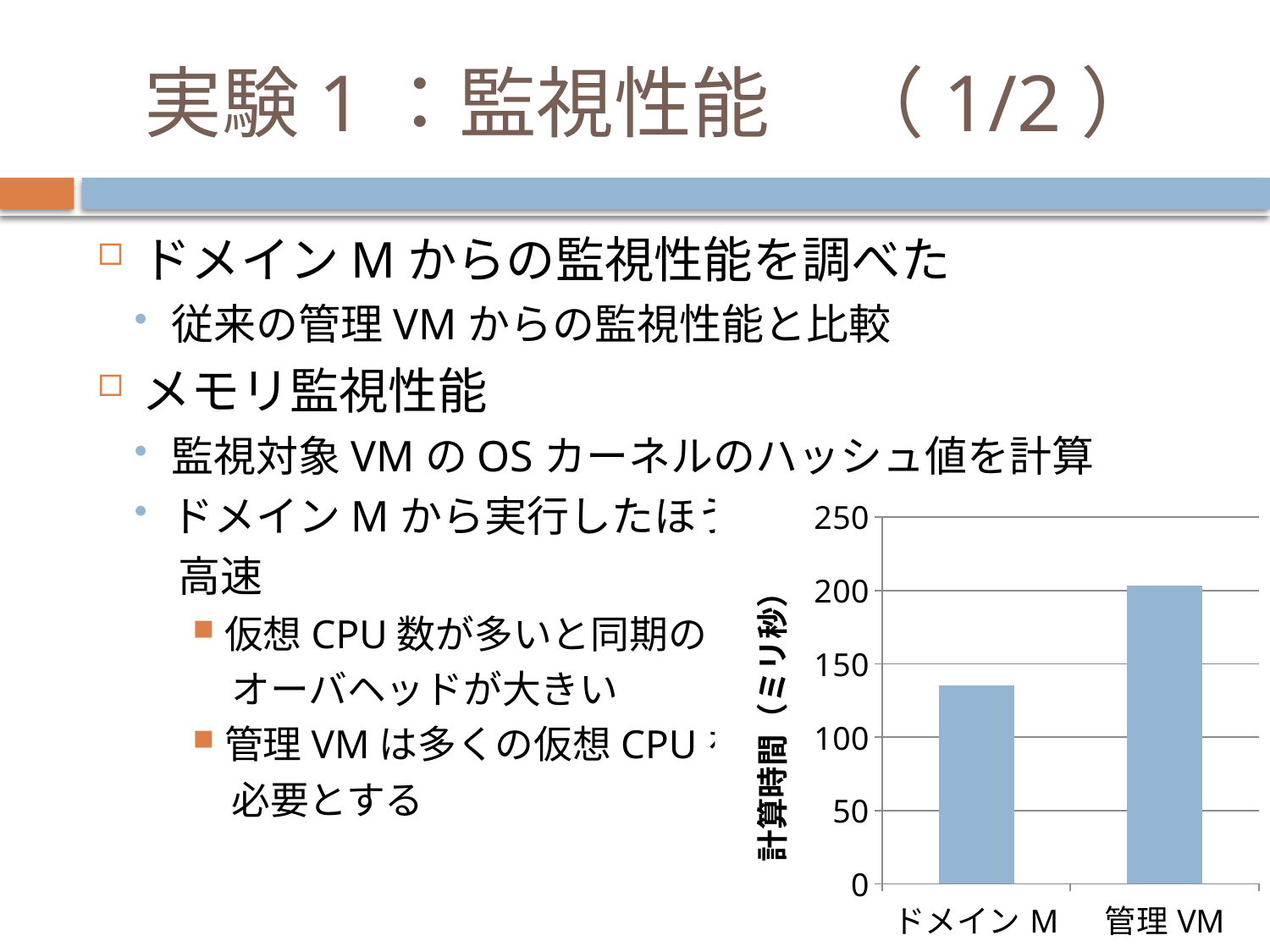
What is the label of the vertical axis of the chart? 計算時間（ミリ秒） Is the value for ドメイン M greater or less than 150? less Which has a larger 計算時間, ドメイン M or 管理 VM? 管理 VM Is the value for 管理 VM greater or less than 150? greater What kind of chart is shown on the slide? bar chart What is the highest tick value shown on the vertical axis of the chart? 250 Is the value for 管理 VM greater or less than 250? less Which category has the highest 計算時間 in the chart? 管理 VM How many categories are plotted on the x axis of the chart? 2 Which category has the lowest 計算時間 in the chart? ドメイン M